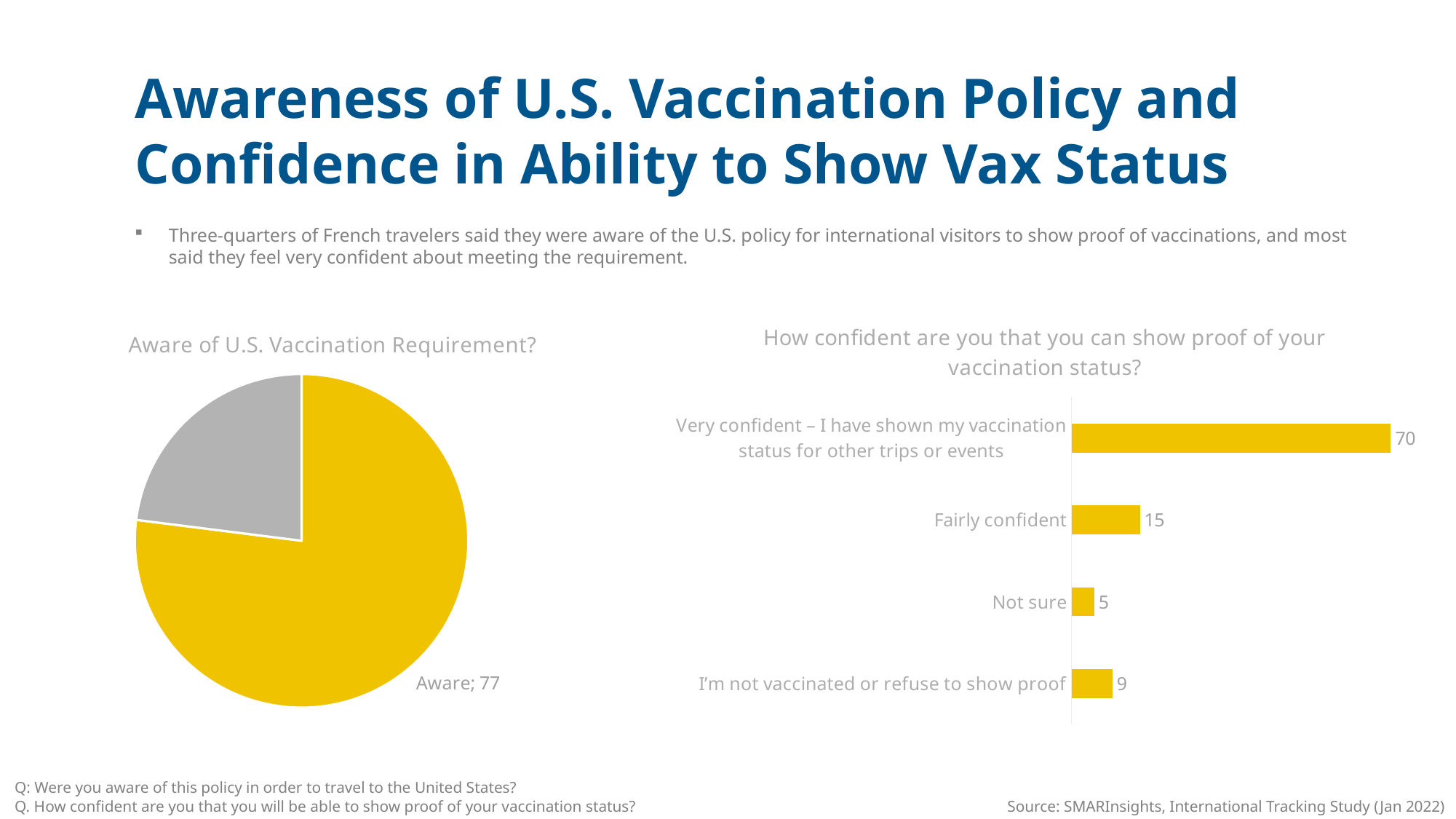
What kind of chart is the one titled "How confident are you that you can show proof of your vaccination status?"? Bar chart In the chart titled "How confident are you that you can show proof of your vaccination status?", what is the value for "Fairly confident"? 15 In the chart titled "Aware of U.S. Vaccination Requirement?", what colour is the "Aware" slice? Yellow In the chart titled "How confident are you that you can show proof of your vaccination status?", what is the value for "Not sure"? 5 How many categories are shown in the chart titled "How confident are you that you can show proof of your vaccination status?"? 4 In the chart titled "How confident are you that you can show proof of your vaccination status?", which is larger: "Not sure" or "I'm not vaccinated or refuse to show proof"? I'm not vaccinated or refuse to show proof What kind of chart is the one titled "Aware of U.S. Vaccination Requirement?"? Pie chart In the chart titled "How confident are you that you can show proof of your vaccination status?", which category has the highest value? Very confident – I have shown my vaccination status for other trips or events In the chart titled "How confident are you that you can show proof of your vaccination status?", what is the difference between the values for "Very confident" and "Fairly confident"? 55 In the chart titled "Aware of U.S. Vaccination Requirement?", what is the value for the "Aware" slice? 77 In the chart titled "How confident are you that you can show proof of your vaccination status?", which category has the lowest value? Not sure In the chart titled "How confident are you that you can show proof of your vaccination status?", what is the value for "I'm not vaccinated or refuse to show proof"? 9